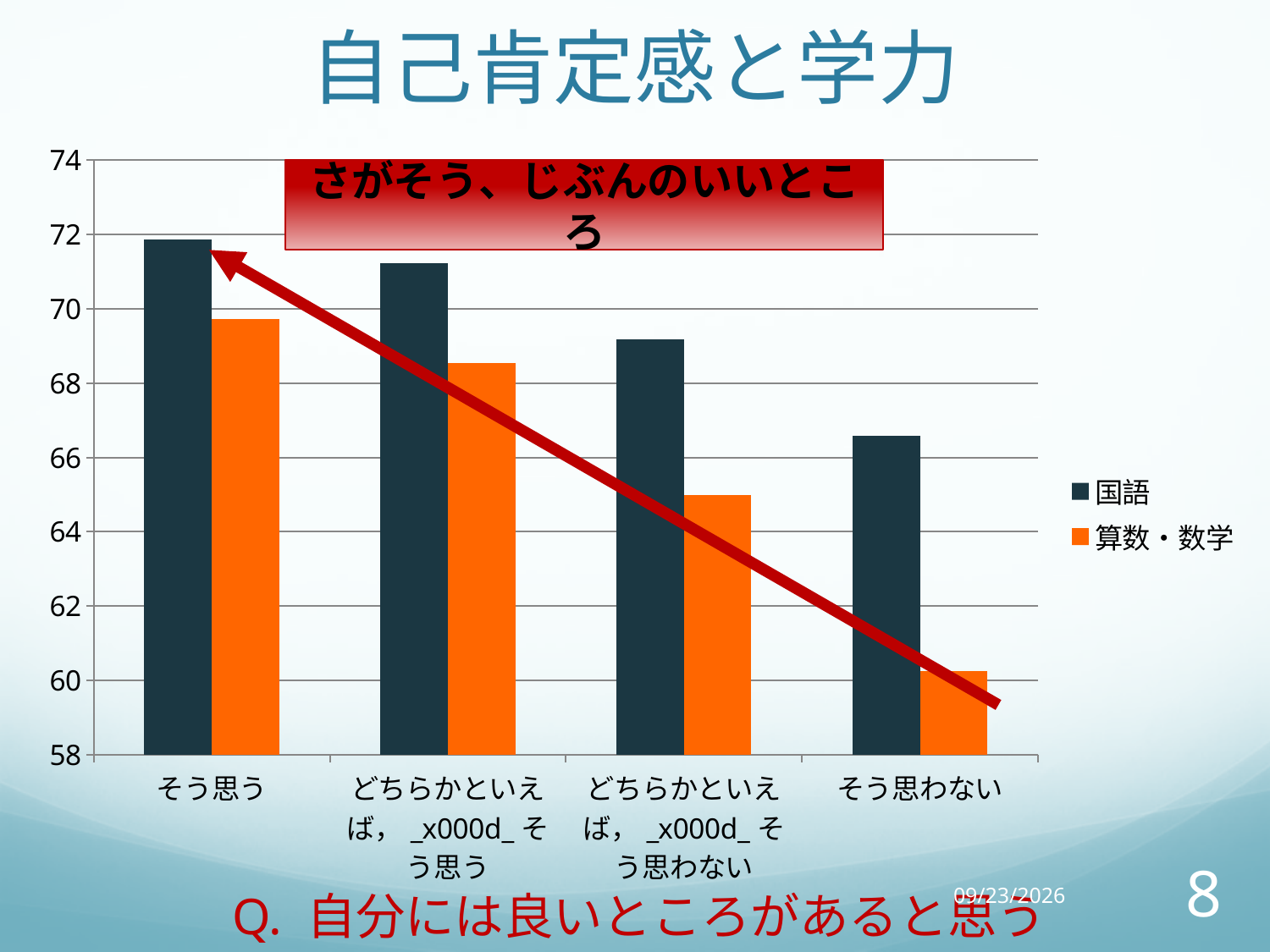
How many categories are shown on the x axis? 4 Is the value for 算数・数学 in the そう思わない category greater or less than 62? less What kind of chart is shown on the slide? bar chart Is the value for 国語 in the そう思う category greater or less than 70? greater Which category has the highest value for 国語? そう思う How many series does the legend list? 2 Is the value for 算数・数学 in the どちらかといえば，そう思わない category greater or less than 66? less In the そう思わない category, which series has the larger value, 国語 or 算数・数学? 国語 Do the values for 算数・数学 rise or fall moving from left to right along the x axis? fall Which category has the lowest value for 算数・数学? そう思わない What is the title of the slide containing the chart? 自己肯定感と学力